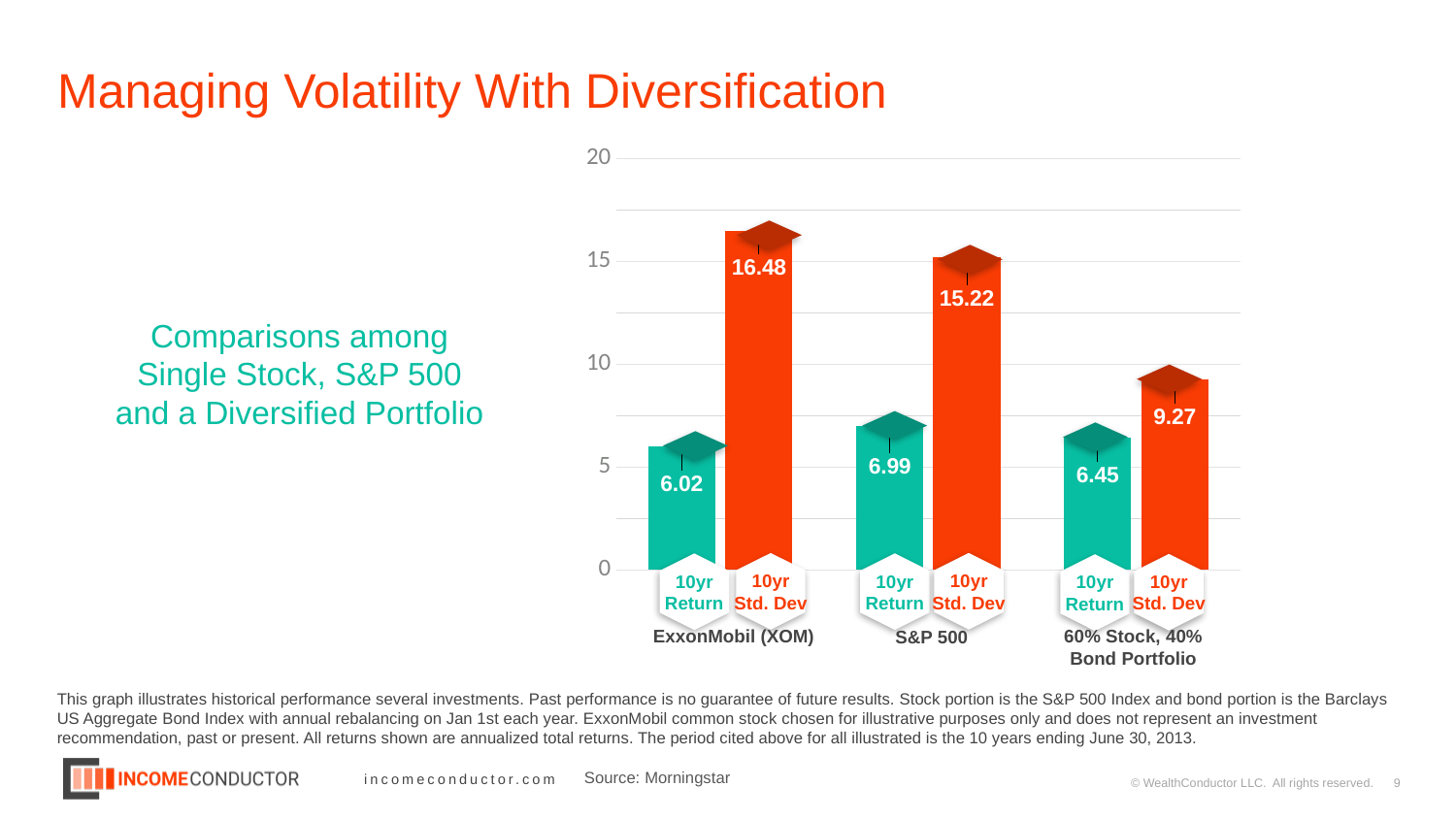
What is the difference between the 10yr Std. Dev of ExxonMobil (XOM) and the S&P 500? 1.26 Which is larger, the 10yr Return of the S&P 500 or the 10yr Return of the 60% Stock, 40% Bond Portfolio? S&P 500 Which category has the lowest 10yr Return? ExxonMobil (XOM) What is the 10yr Std. Dev value for the 60% Stock, 40% Bond Portfolio? 9.27 What is the source cited for the chart data? Morningstar Which category has the highest 10yr Std. Dev? ExxonMobil (XOM) Is the 10yr Std. Dev for the S&P 500 greater or less than 15? greater How many investment categories are shown on the x axis? 3 What kind of chart is shown on the slide? bar chart What is the 10yr Return value for the S&P 500? 6.99 What is the difference between the 10yr Return and 10yr Std. Dev for the 60% Stock, 40% Bond Portfolio? 2.82 What is the 10yr Std. Dev value for ExxonMobil (XOM)? 16.48